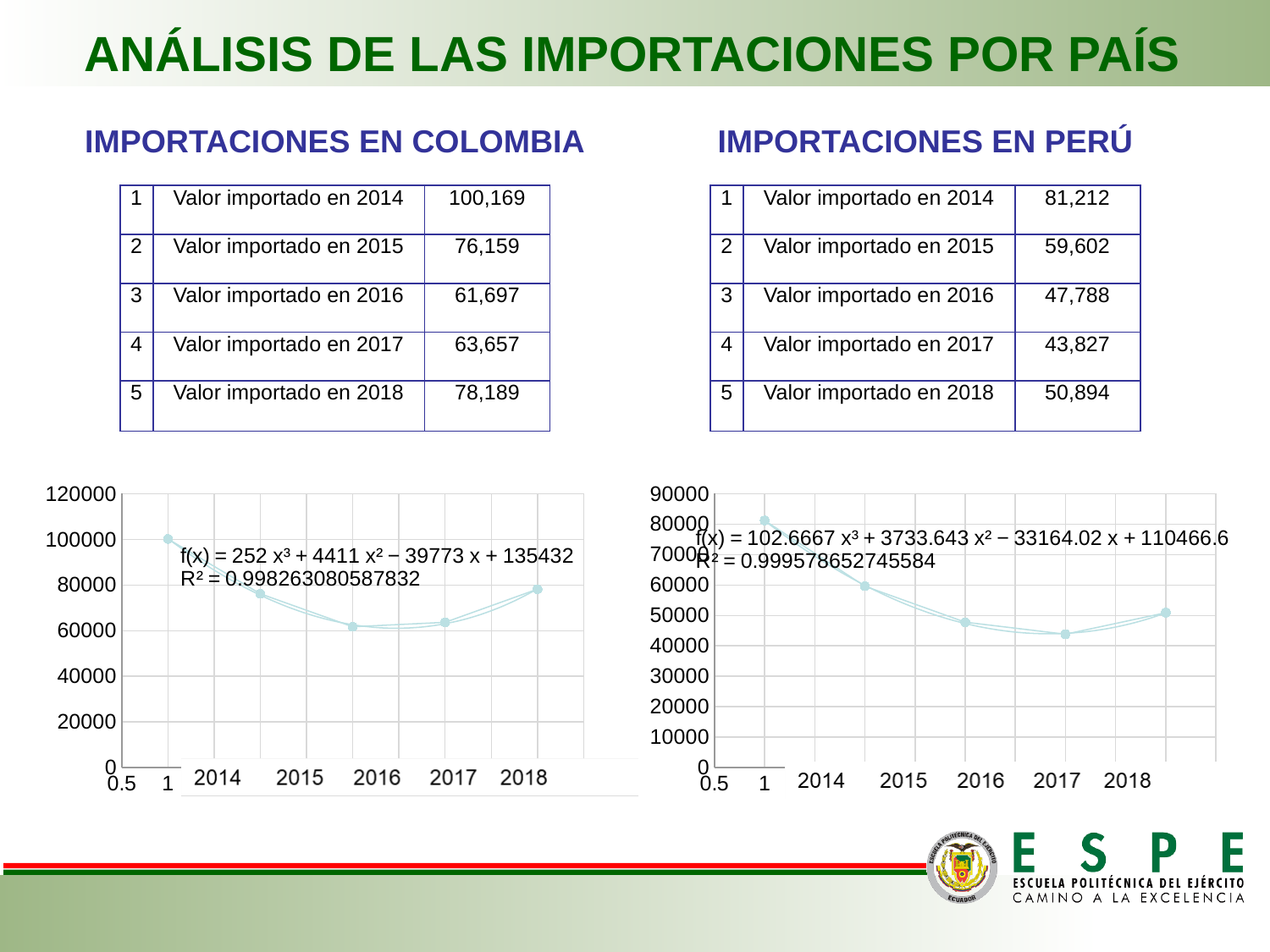
On the IMPORTACIONES EN COLOMBIA chart, is the value for 2014 greater or less than 80000? greater On the IMPORTACIONES EN COLOMBIA chart, which year has the lowest value? 2016 How many data points are plotted on the IMPORTACIONES EN PERÚ chart? 5 On the IMPORTACIONES EN PERÚ chart, which year has the lowest value? 2017 On the IMPORTACIONES EN COLOMBIA chart, do the values rise or fall from 2014 to 2016? fall On the IMPORTACIONES EN PERÚ chart, is the value for 2017 greater or less than 50000? less Using the IMPORTACIONES EN PERÚ table, what is the difference between the Valor importado en 2014 and the Valor importado en 2018? 30,318 On the IMPORTACIONES EN COLOMBIA chart, which year has the highest value? 2014 Which is larger: the 2014 value on the IMPORTACIONES EN COLOMBIA chart or the 2014 value on the IMPORTACIONES EN PERÚ chart? Colombia What R² value is shown on the IMPORTACIONES EN COLOMBIA chart? 0.998263080587832 What kind of chart is the left chart under IMPORTACIONES EN COLOMBIA? line chart According to the IMPORTACIONES EN COLOMBIA table, what is the Valor importado en 2016? 61,697